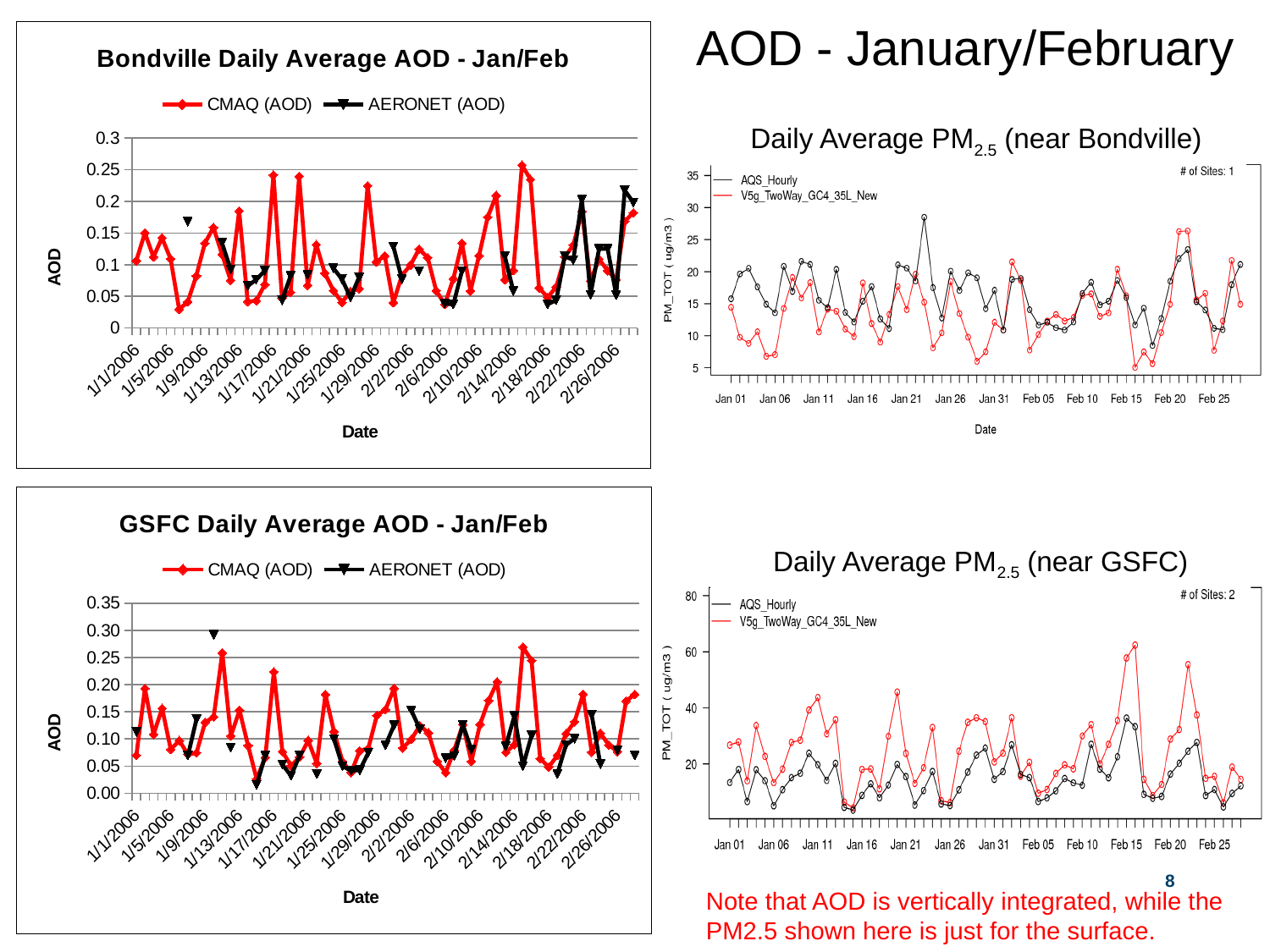
In the "Daily Average PM2.5 (near GSFC)" chart, is the highest value of the V5g_TwoWay_GC4_35L_New series greater or less than 40? greater In the "Daily Average PM2.5 (near GSFC)" chart, which series reaches the higher peak value? V5g_TwoWay_GC4_35L_New What are the two legend entries in the "GSFC Daily Average AOD - Jan/Feb" chart? CMAQ (AOD) and AERONET (AOD) What kind of chart is the "Bondville Daily Average AOD - Jan/Feb" chart? Line chart How many series does the legend of the "Bondville Daily Average AOD - Jan/Feb" chart list? 2 In the "Bondville Daily Average AOD - Jan/Feb" chart, which series reaches the highest AOD value? CMAQ (AOD) What kind of chart is the "Daily Average PM2.5 (near GSFC)" chart? Line chart How many date labels are shown on the x axis of the "Bondville Daily Average AOD - Jan/Feb" chart? 15 In the "Daily Average PM2.5 (near Bondville)" chart, is the highest AQS_Hourly value greater or less than 25? greater In the "Daily Average PM2.5 (near GSFC)" chart, how many sites are indicated in the top-right corner? 2 How many series does the legend of the "Daily Average PM2.5 (near Bondville)" chart list? 2 In the "GSFC Daily Average AOD - Jan/Feb" chart, is the CMAQ (AOD) value on 1/1/2006 greater or less than 0.10? less